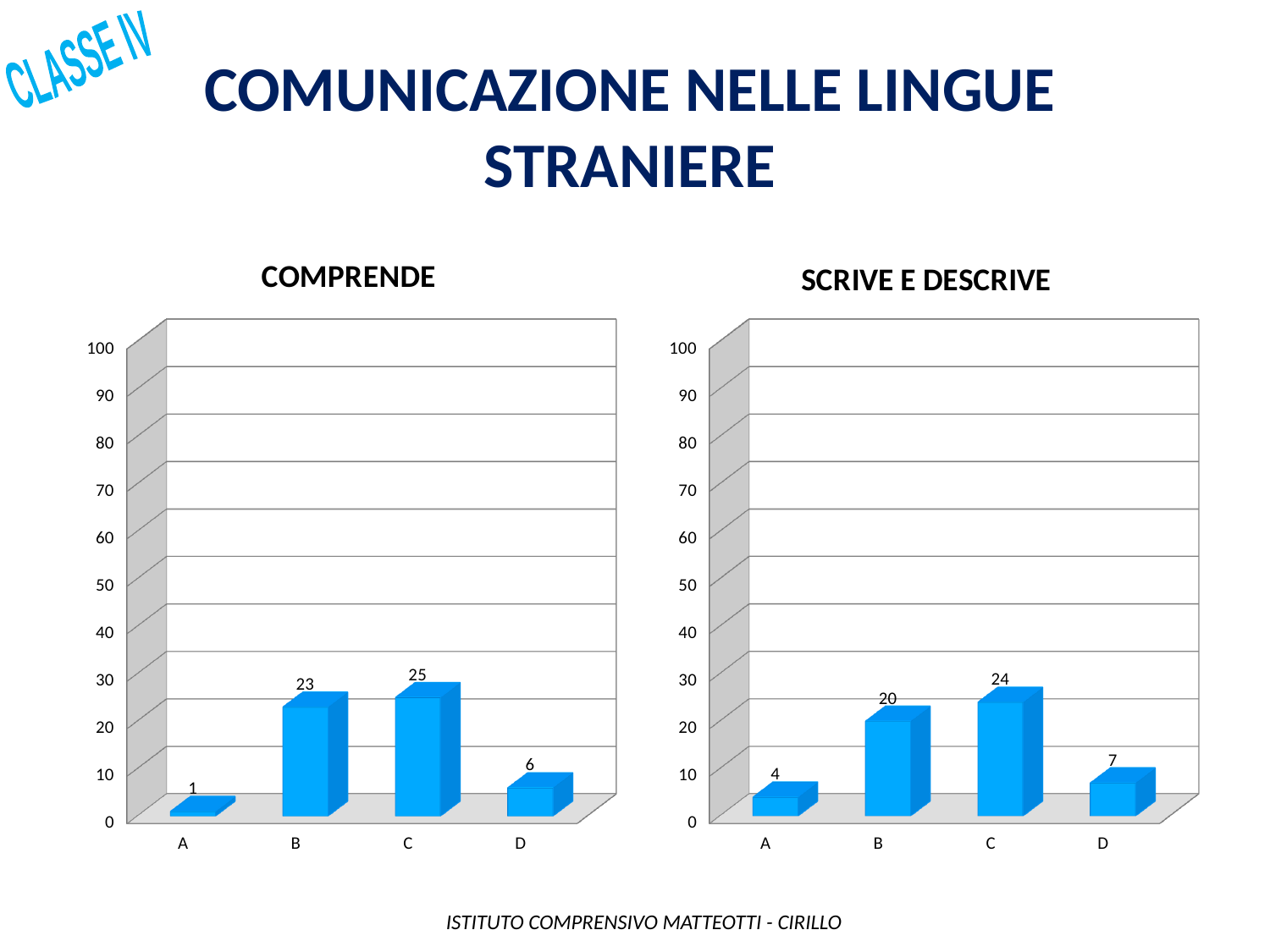
In the COMPRENDE chart, what is the value for category C? 25 How many categories are shown in the SCRIVE E DESCRIVE chart? 4 In the SCRIVE E DESCRIVE chart, which is larger, the value for B or the value for C? C In the COMPRENDE chart, what is the value for category A? 1 In the COMPRENDE chart, is the value for B greater or less than 30? less What kind of chart is the COMPRENDE chart? bar chart In the SCRIVE E DESCRIVE chart, what is the value for category D? 7 In the COMPRENDE chart, which category has the highest value? C In the SCRIVE E DESCRIVE chart, what is the value for category B? 20 In the SCRIVE E DESCRIVE chart, which category has the lowest value? A In the COMPRENDE chart, what is the difference between the values for B and D? 17 In the SCRIVE E DESCRIVE chart, what is the difference between the values for C and A? 20